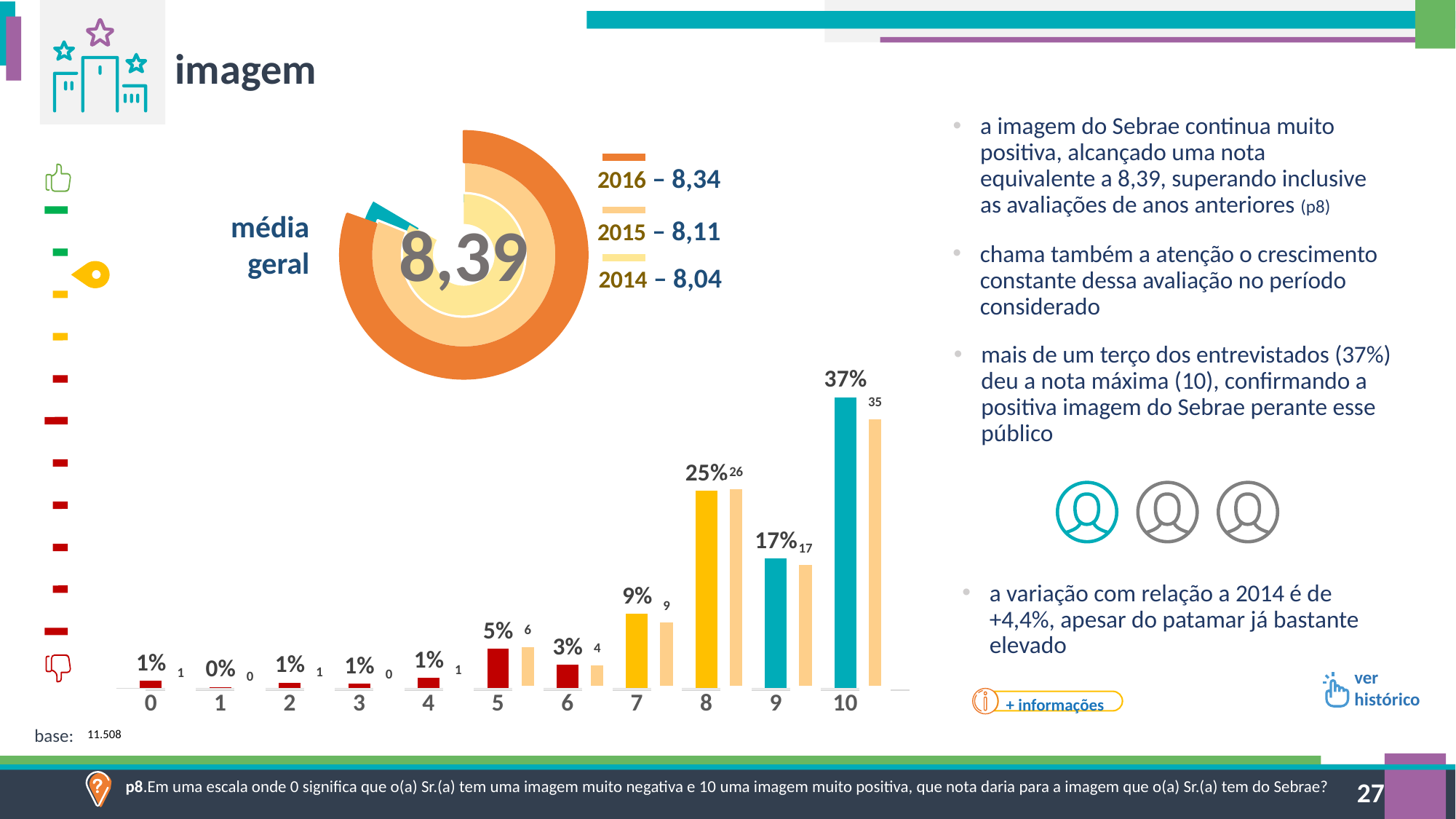
In the bar chart, what percentage of respondents gave the score 8? 25% In the bar chart, what is the difference in percentage points between the score 10 and the score 8? 12 In the bar chart, what percentage of respondents gave the score 5? 5% In the bar chart, which has a larger percentage: score 9 or score 7? 9 In the ring chart, what is the value shown for 2015? 8,11 In the bar chart, what is the small value printed next to the lighter bar for score 10? 35 What kind of chart shows the distribution of scores from 0 to 10? bar chart In the bar chart, what percentage of respondents gave the score 10? 37% In the bar chart, which score has the highest percentage? 10 How many score categories are shown on the x axis of the bar chart? 11 In the ring chart, which year has the lowest value? 2014 What is the 'média geral' value shown in the centre of the ring chart? 8,39